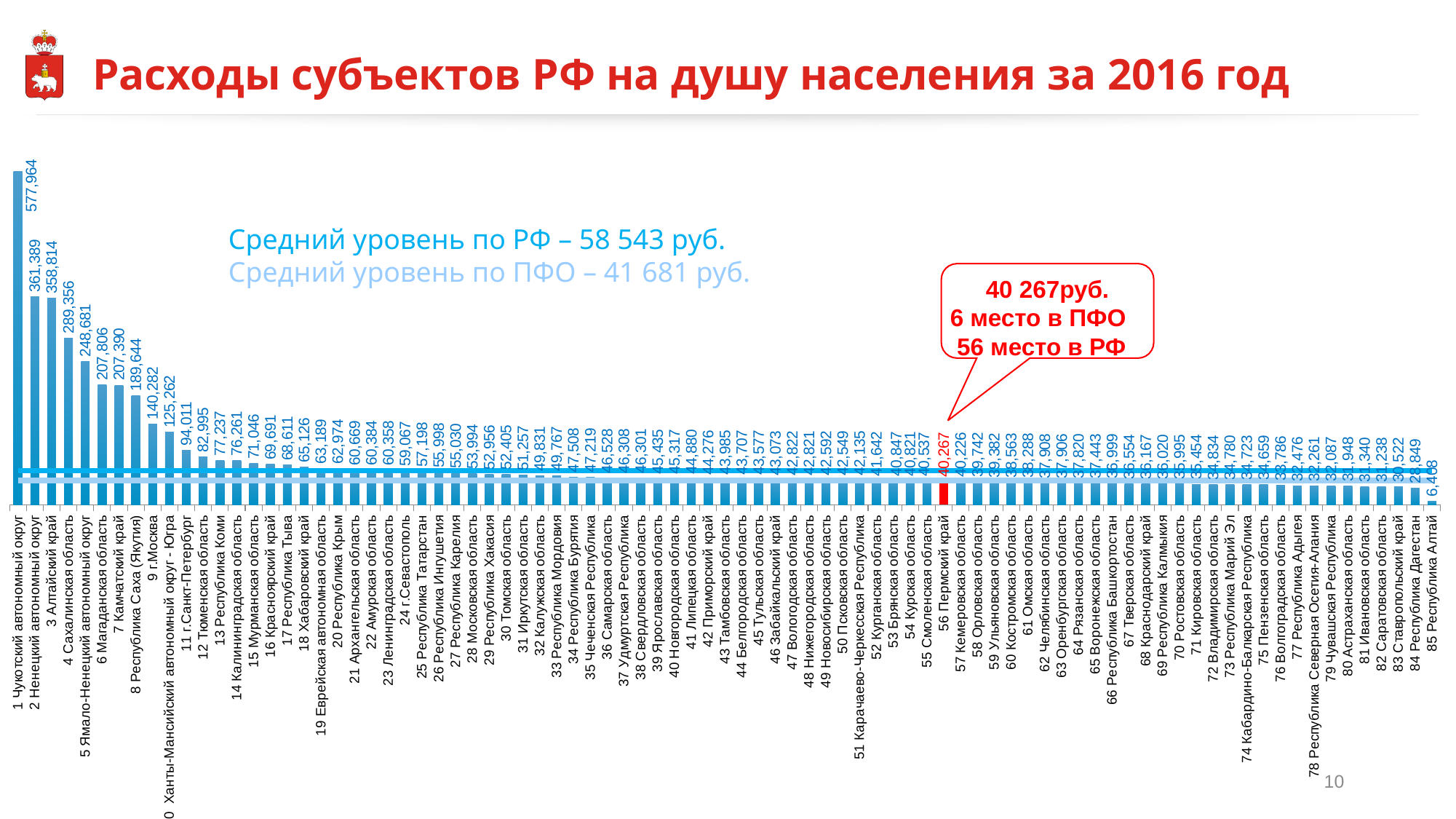
What is the value for г.Москва? 140,282 Which region has the lowest value on the chart? Республика Алтай What is the value for Чукотский автономный округ? 577,964 Which region's bar is highlighted in red? Пермский край What is the value for Сахалинская область? 289,356 What is the value for Тюменская область? 82,995 What kind of chart is shown on the slide? bar chart What is the difference between the values for Чукотский автономный округ and Ненецкий автономный округ? 216,575 Which is larger, the value for г.Москва or the value for г.Санкт-Петербург? г.Москва What is the difference between the values for Ненецкий автономный округ and Алтайский край? 2,575 What is the value for Пермский край? 40,267 Which region has the highest value on the chart? Чукотский автономный округ